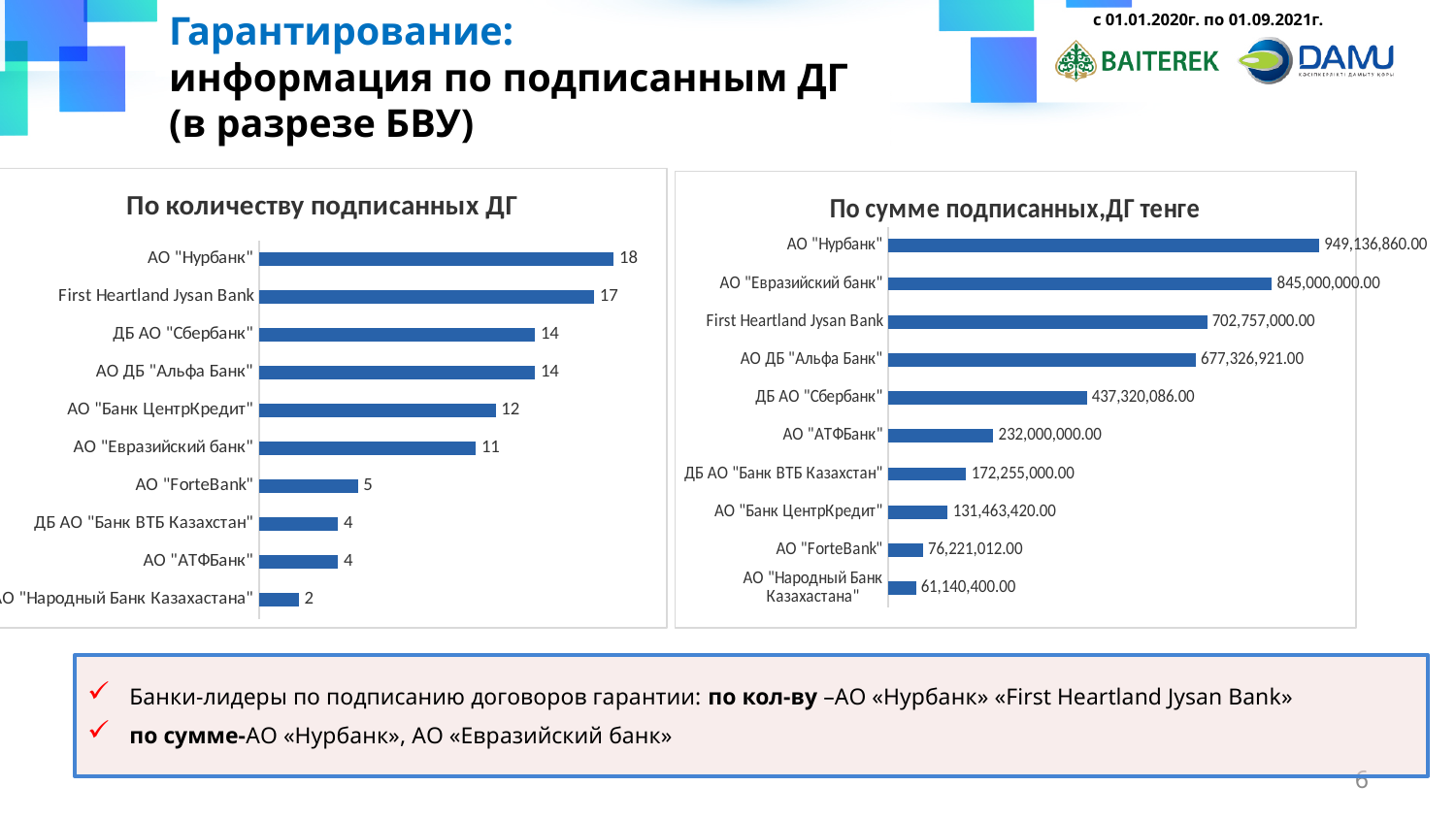
In the chart titled "По количеству подписанных ДГ", which is larger: АО "ForteBank" or ДБ АО "Банк ВТБ Казахстан"? АО "ForteBank" In the chart titled "По количеству подписанных ДГ", how many banks are shown? 10 In the chart titled "По сумме подписанных,ДГ тенге", which bank has the lowest value? АО "Народный Банк Казахастана" What type of chart is the chart titled "По сумме подписанных,ДГ тенге"? Bar chart In the chart titled "По сумме подписанных,ДГ тенге", which is larger: АО "АТФБанк" or АО "Банк ЦентрКредит"? АО "АТФБанк" In the chart titled "По сумме подписанных,ДГ тенге", what is the difference between АО "Нурбанк" and АО "Евразийский банк"? 104,136,860.00 In the chart titled "По количеству подписанных ДГ", what is the difference between First Heartland Jysan Bank and АО "Евразийский банк"? 6 In the chart titled "По количеству подписанных ДГ", what is the value for АО "Нурбанк"? 18 In the chart titled "По количеству подписанных ДГ", which bank has the highest value? АО "Нурбанк" In the chart titled "По количеству подписанных ДГ", what is the value for АО "Банк ЦентрКредит"? 12 In the chart titled "По сумме подписанных,ДГ тенге", what is the value for ДБ АО "Сбербанк"? 437,320,086.00 In the chart titled "По сумме подписанных,ДГ тенге", what is the value for АО "Евразийский банк"? 845,000,000.00